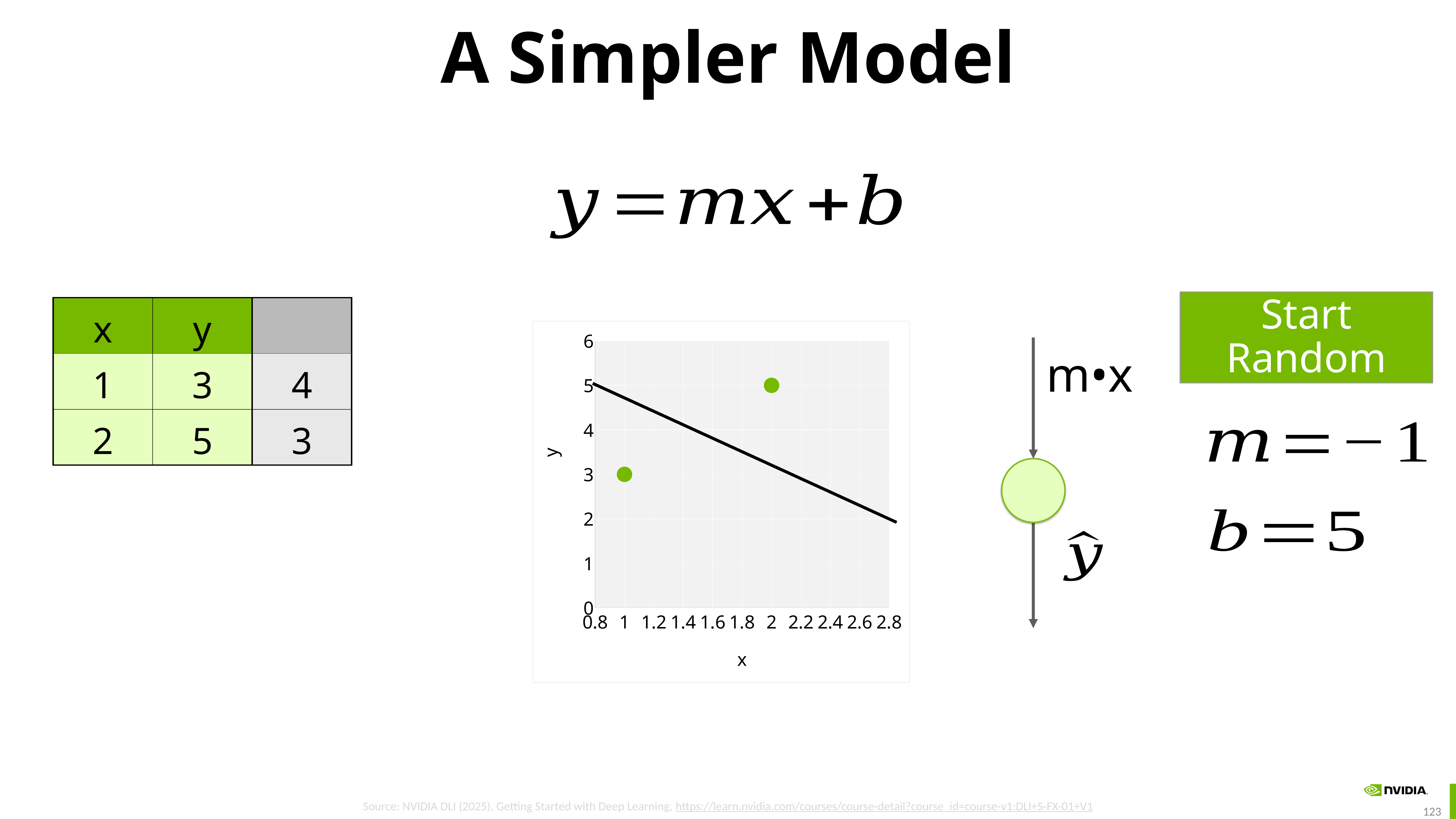
Do the plotted data points rise or fall as x increases? rise Is the value of the black line at x = 2.8 greater or less than 3? less Does the black line on the chart rise or fall as x increases? fall What kind of chart is shown on the slide? scatter chart Which plotted point has the larger y value, the one at x = 1 or the one at x = 2? x = 2 What is the y value of the plotted point at x = 2? 5 What is the difference between the y values of the points at x = 2 and x = 1? 2 At which x value does the plotted point with the lowest y value lie? 1 At which x value does the plotted point with the highest y value lie? 2 What is the y value of the plotted point at x = 1? 3 How many data points are plotted on the chart? 2 What is the label of the vertical axis of the chart? y